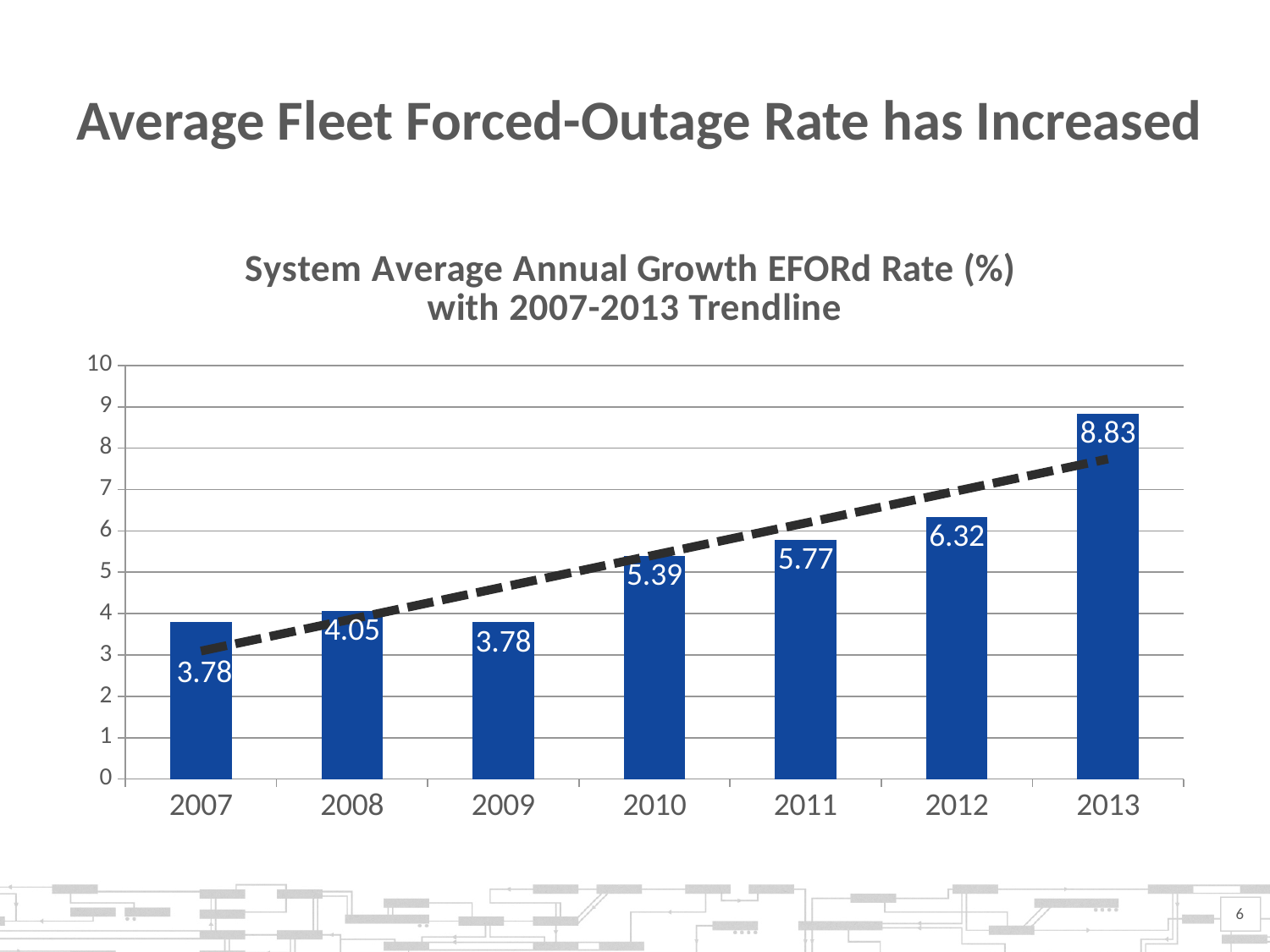
What is the title of the chart? System Average Annual Growth EFORd Rate (%) with 2007-2013 Trendline Is the value for 2012 greater or less than 6? greater What is the EFORd rate for 2010? 5.39 Which year has the highest EFORd rate? 2013 What is the difference between the 2011 and 2010 EFORd rates? 0.38 What kind of chart is shown on the slide? bar chart What is the EFORd rate for 2013? 8.83 What is the EFORd rate for 2008? 4.05 Do the EFORd rates generally rise or fall from 2007 to 2013? rise How many years are shown on the x axis? 7 Which year has the larger EFORd rate, 2008 or 2009? 2008 What is the difference between the 2013 and 2012 EFORd rates? 2.51